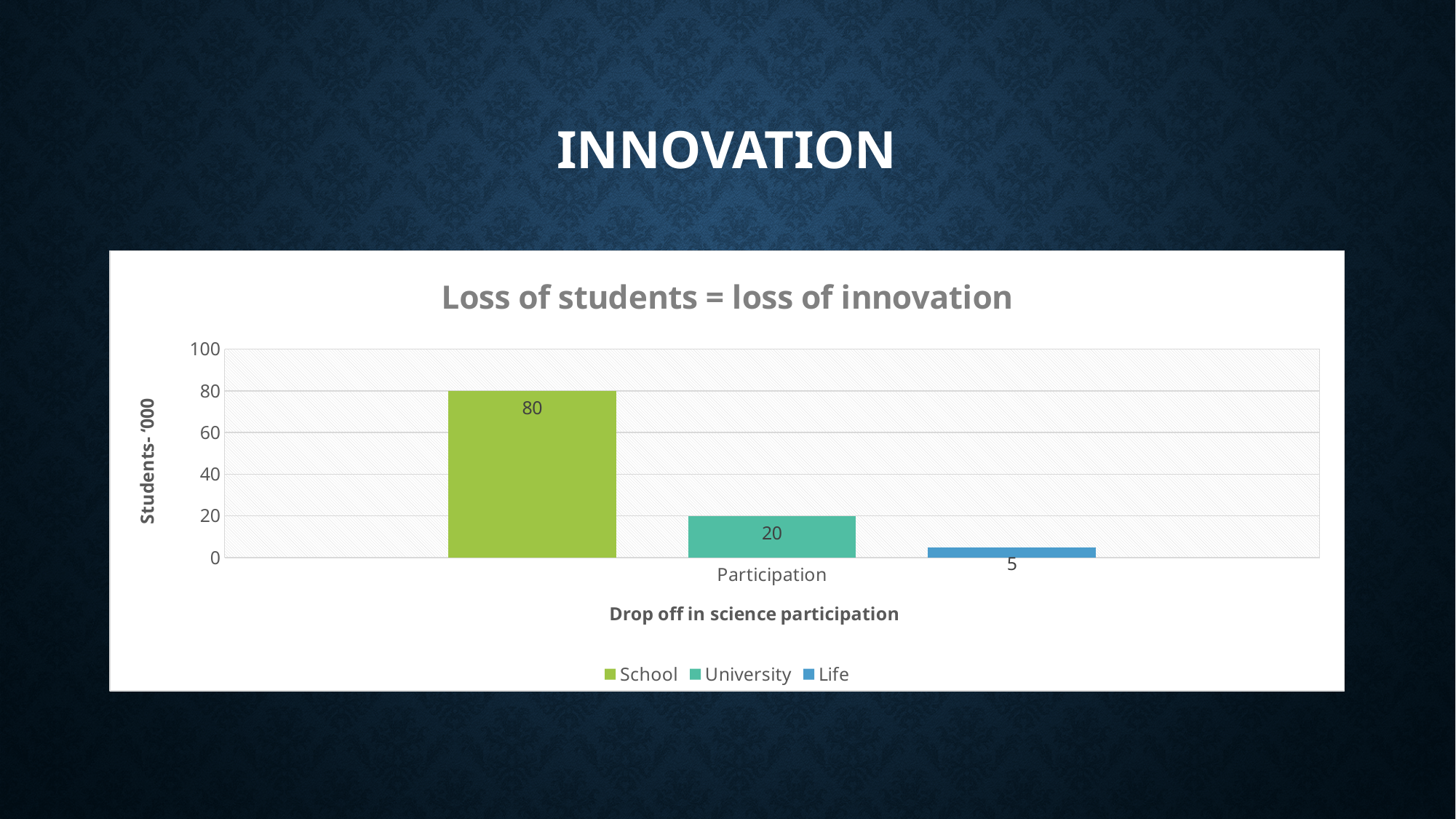
Which series has the highest value? School What is the value for Life? 5 What is the value for University? 20 What is the title of the chart? Loss of students = loss of innovation What is the label of the vertical axis? Students- '000 Which is larger, the value for University or the value for Life? University What is the value for School? 80 How many series does the legend list? 3 Which series has the lowest value? Life What kind of chart is shown? Bar chart What is the difference between the University and Life values? 15 What is the difference between the School and University values? 60